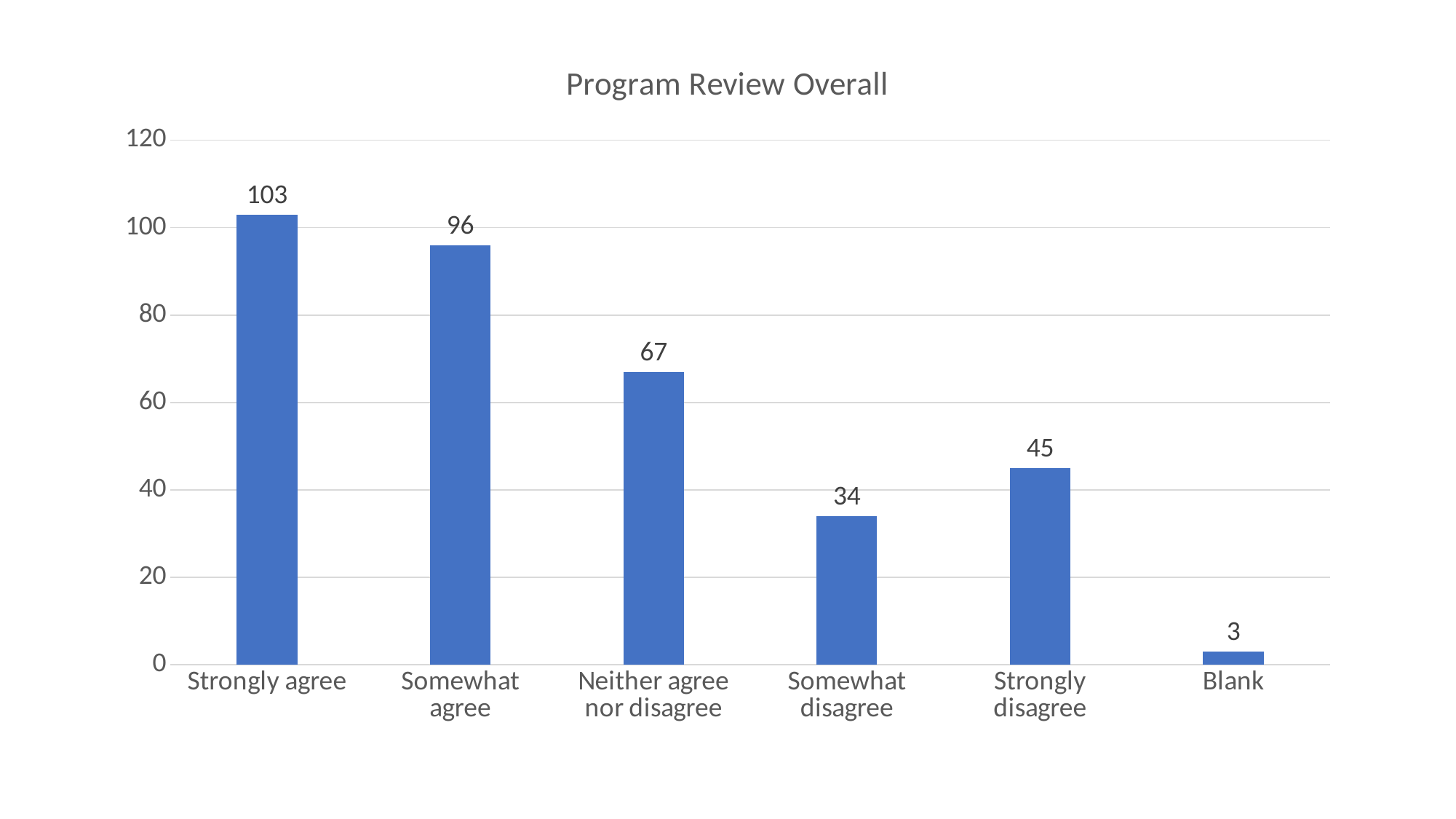
Which category has the highest value? Strongly agree Is the value for Neither agree nor disagree greater or less than 60? greater What is the title of the chart? Program Review Overall How many categories are shown on the x axis? 6 What is the difference between Strongly agree and Somewhat agree? 7 What is the difference between Strongly disagree and Somewhat disagree? 11 What is the value for Blank? 3 Which category has the lowest value? Blank What is the value for Strongly agree? 103 Which is larger, Somewhat disagree or Strongly disagree? Strongly disagree What kind of chart is this? bar chart What is the value for Neither agree nor disagree? 67